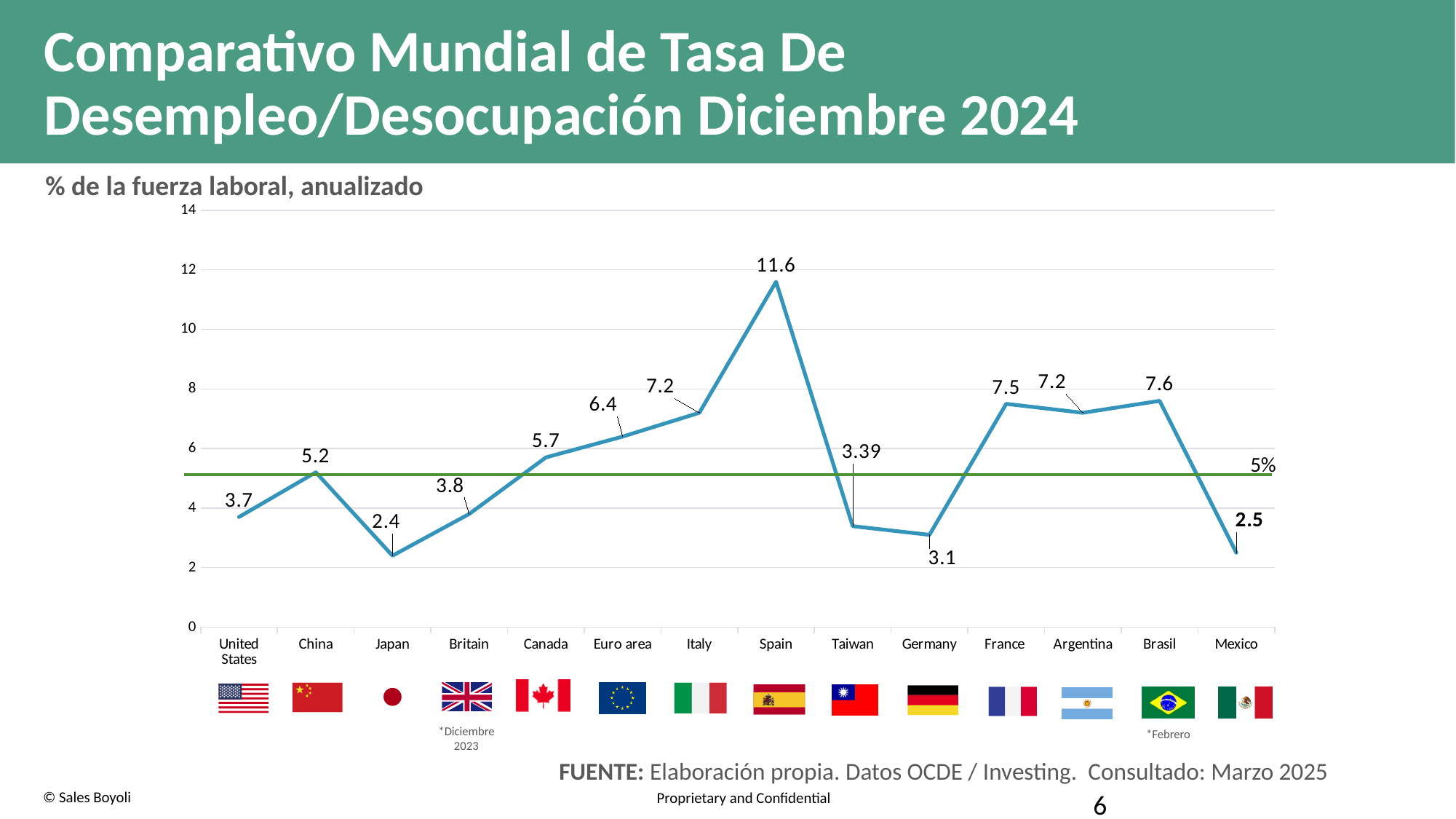
Which country has the highest unemployment rate on the chart? Spain What is the difference between the values for Spain and Japan? 9.2 What is the unemployment rate shown for Spain? 11.6 Which has a higher unemployment rate, Canada or China? Canada What value does the horizontal green reference line mark? 5% Is the value for Euro area greater or less than 6? greater What is the value shown for Mexico? 2.5 What kind of chart is used on this slide? Line chart What is the difference between the values for Brasil and Germany? 4.5 What is the value plotted for Taiwan? 3.39 Which country has the lowest unemployment rate on the chart? Japan How many countries or regions are plotted on the chart? 14